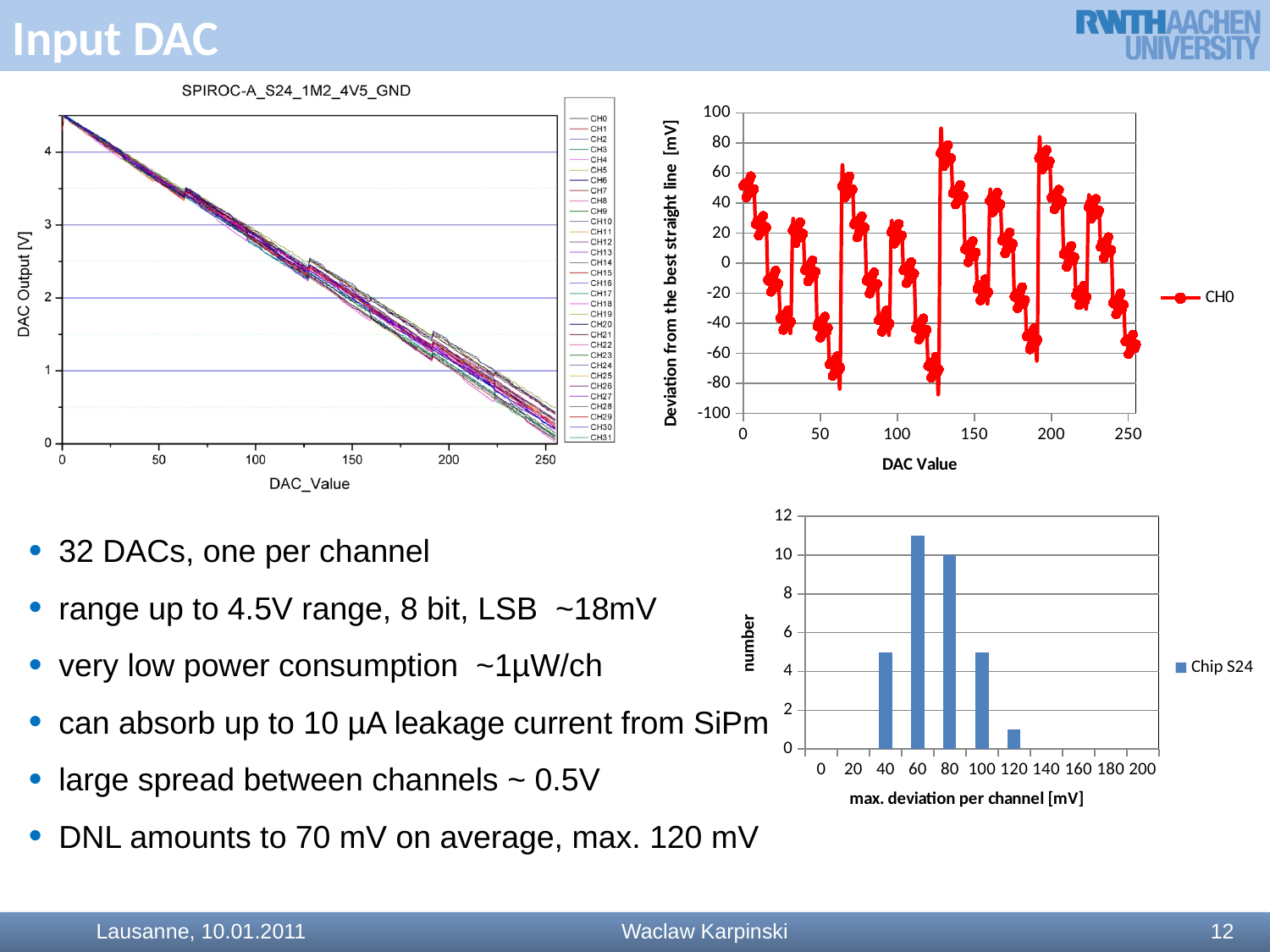
How many series does the legend of the top-right chart (Deviation from the best straight line) list? 1 In the bottom-right bar chart, which x-axis bin has the shortest bar? 120 In the bottom-right bar chart, is the value of the bar at 40 greater or less than 4? greater In the bottom-right bar chart, is the value of the bar at 60 greater or less than 10? greater What kind of chart is the bottom-right chart with the x axis 'max. deviation per channel [mV]'? bar chart In the bottom-right bar chart, which bar is taller: the one at 60 or the one at 100? 60 In the bottom-right bar chart, how many bars are plotted? 5 In the bottom-right bar chart, is the value of the bar at 120 greater or less than 2? less In the bottom-right bar chart, which x-axis bin has the tallest bar? 60 What is the legend entry of the bottom-right bar chart? Chip S24 In the bottom-right bar chart, what is the number for the bar at 80 mV? 10 In the top-left chart titled SPIROC-A_S24_1M2_4V5_GND, do the DAC Output values rise or fall as DAC_Value increases? fall